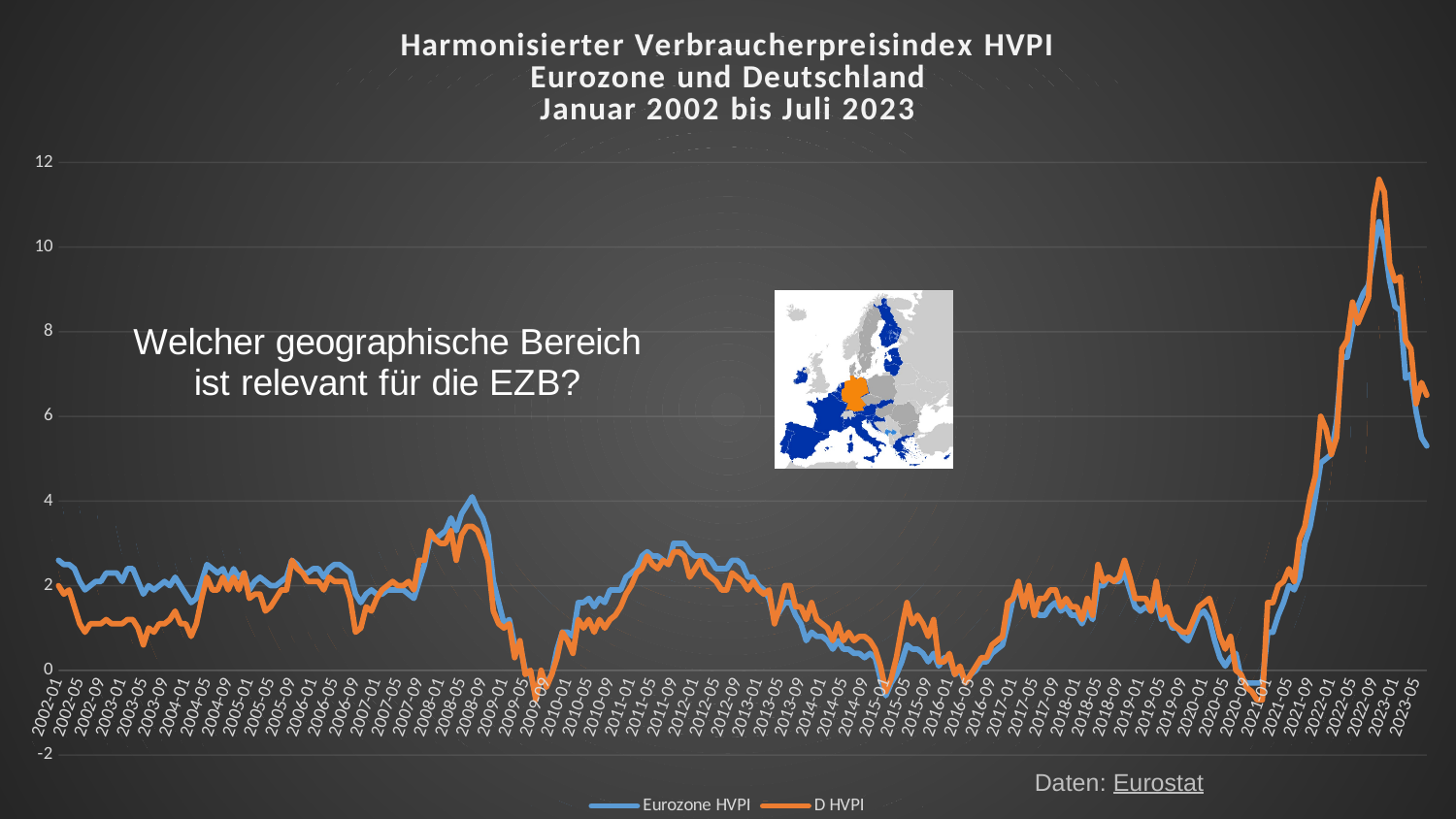
Do the values rise or fall between 2021-01 and 2022-09? rise Is the peak value of D HVPI in late 2022 greater or less than 10? greater What colour is the D HVPI line? orange What are the two series named in the legend? Eurozone HVPI and D HVPI Do the values rise or fall between 2022-10 and 2023-05? fall Is the value for Eurozone HVPI around 2009-07 greater or less than 0? less Is the peak value of Eurozone HVPI in late 2022 greater or less than 8? greater Which series is higher at the peak in late 2022, Eurozone HVPI or D HVPI? D HVPI Which series reaches the highest value on the chart? D HVPI What kind of chart is shown on the slide? line chart How many series does the legend list? 2